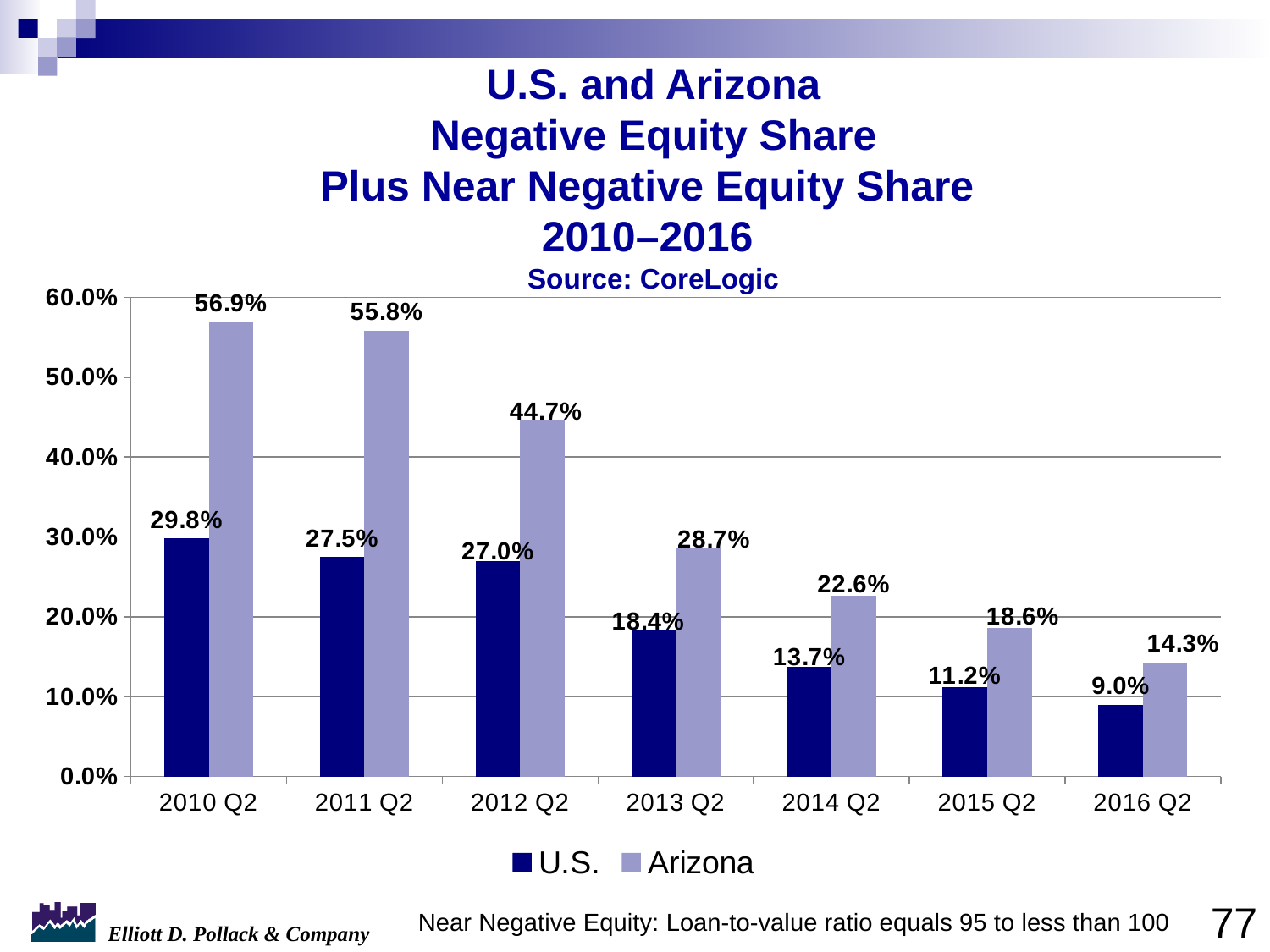
What is the Arizona value for 2010 Q2? 56.9% What is the difference between the Arizona and U.S. values in 2012 Q2? 17.7% How many periods are shown on the x axis? 7 What is the U.S. value for 2014 Q2? 13.7% Is the Arizona value for 2011 Q2 greater or less than 50.0%? greater Which is larger in 2013 Q2, the U.S. value or the Arizona value? Arizona In which period is the Arizona value highest? 2010 Q2 In which period is the U.S. value lowest? 2016 Q2 How many series does the legend list? 2 What is the U.S. value for 2016 Q2? 9.0% Do the Arizona values rise or fall from 2010 Q2 to 2016 Q2? fall What kind of chart is shown on the slide? bar chart